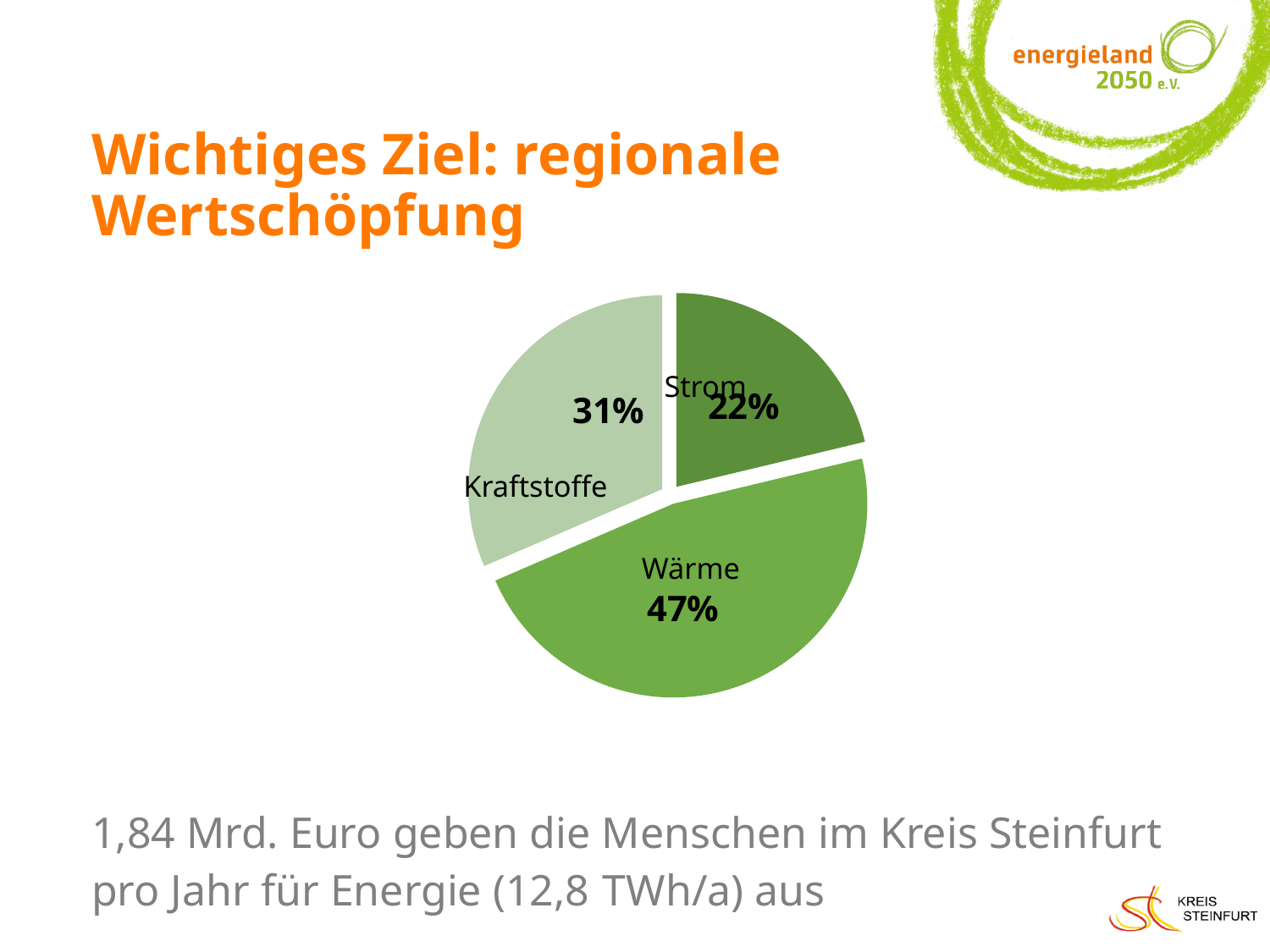
What kind of chart is shown on the slide? Pie chart Which is larger, the share for Kraftstoffe or the share for Strom? Kraftstoffe What share of the pie does Kraftstoffe have? 31% What share of the pie does Wärme have? 47% How many slices does the pie chart have? 3 What share of the pie does Strom have? 22% What is the title of the slide containing the chart? Wichtiges Ziel: regionale Wertschöpfung What is the combined share of Wärme and Kraftstoffe? 78% Which category has the smallest slice of the pie? Strom Which category has the largest slice of the pie? Wärme What is the difference in percentage points between Wärme and Strom? 25 What is the difference in percentage points between Kraftstoffe and Strom? 9